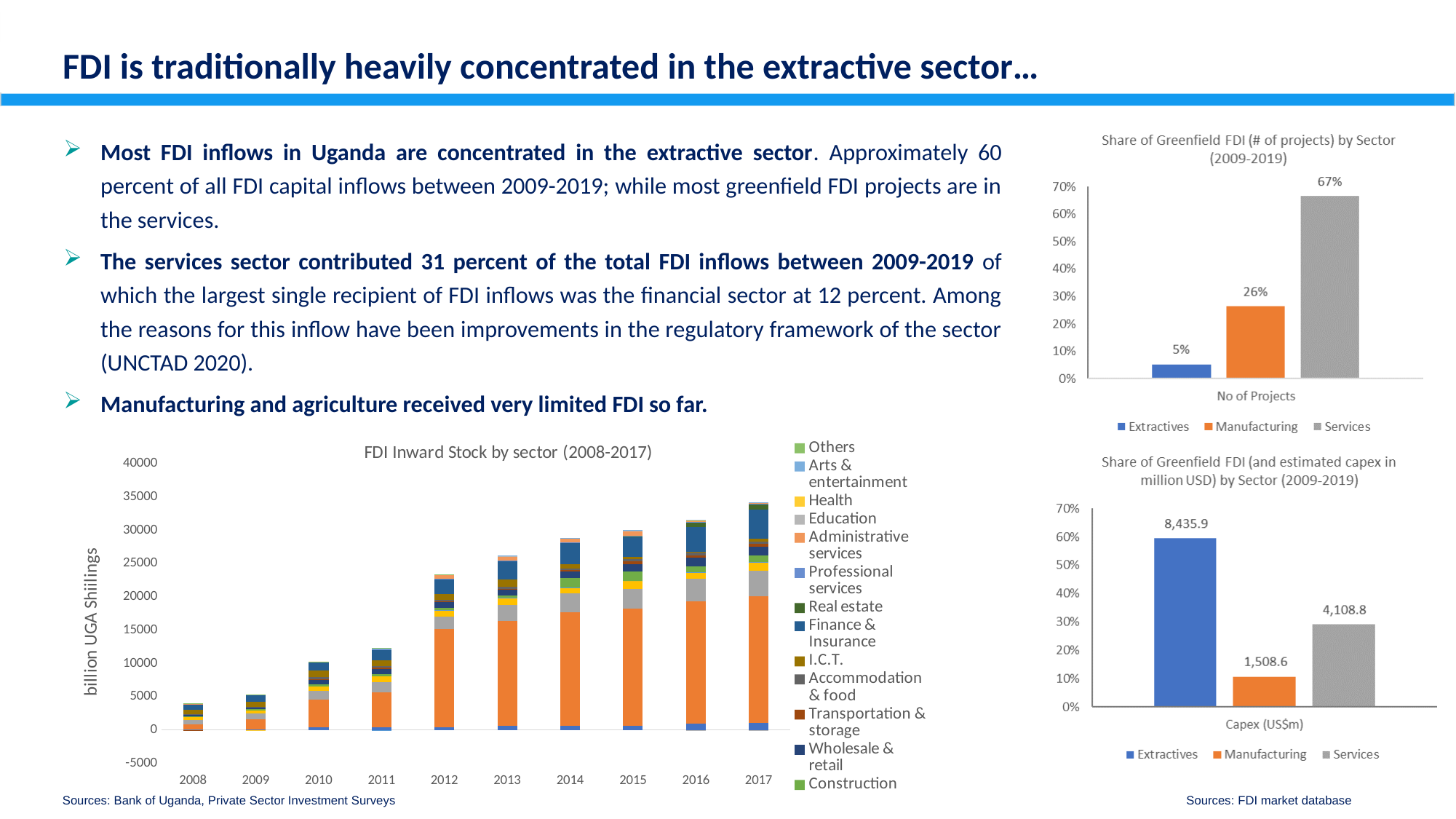
How many years are shown on the x axis of the 'FDI Inward Stock by sector (2008-2017)' chart? 10 In the 'FDI Inward Stock by sector (2008-2017)' chart, do the total stacked values generally rise or fall from 2008 to 2017? Rise What type of chart is 'FDI Inward Stock by sector (2008-2017)'? Stacked bar chart In the 'Share of Greenfield FDI (# of projects) by Sector (2009-2019)' chart, what is the value for Extractives? 5% In the 'Share of Greenfield FDI (# of projects) by Sector (2009-2019)' chart, what is the value for Services? 67% In the 'Share of Greenfield FDI (and estimated capex in million USD) by Sector (2009-2019)' chart, is the share for Extractives greater or less than 50%? greater In the 'Share of Greenfield FDI (# of projects) by Sector (2009-2019)' chart, what is the difference between the Services and Manufacturing shares? 41% In the 'Share of Greenfield FDI (and estimated capex in million USD) by Sector (2009-2019)' chart, which sector has the lowest capex? Manufacturing In the 'Share of Greenfield FDI (and estimated capex in million USD) by Sector (2009-2019)' chart, what is the capex label for Extractives? 8,435.9 In the 'Share of Greenfield FDI (and estimated capex in million USD) by Sector (2009-2019)' chart, which is larger, the capex for Services or for Manufacturing? Services In the 'Share of Greenfield FDI (and estimated capex in million USD) by Sector (2009-2019)' chart, what is the capex label for Manufacturing? 1,508.6 In the 'Share of Greenfield FDI (# of projects) by Sector (2009-2019)' chart, which sector has the highest share? Services